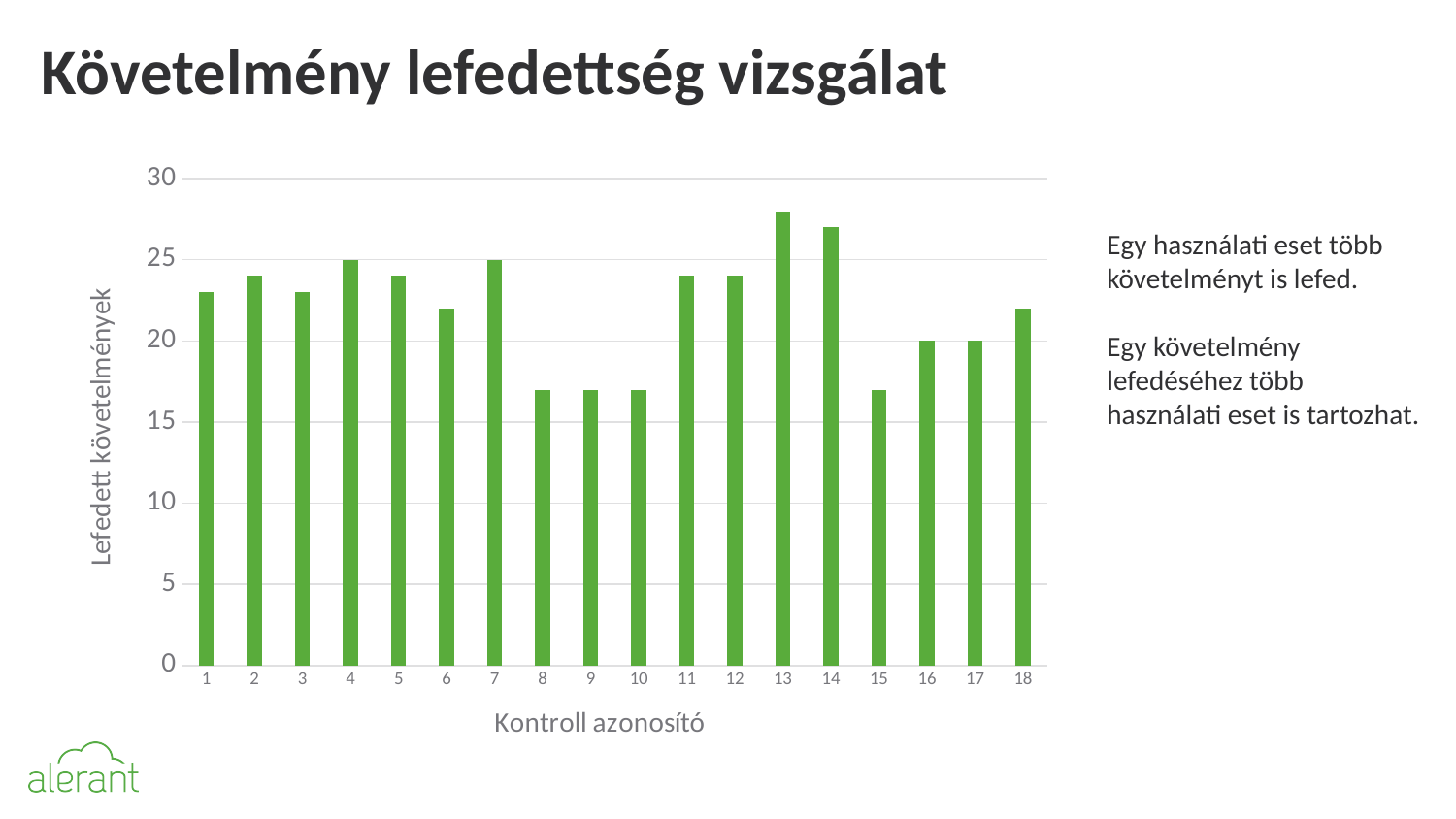
What is the title of the chart's y axis? Lefedett követelmények Is the value for control identifier 8 greater or less than 20? less Is the value for control identifier 15 greater or less than 20? less Which control identifier has the highest number of covered requirements? 13 How many control identifiers (categories) are plotted on the x axis? 18 Which has a larger value, control identifier 13 or control identifier 9? 13 Is the value for control identifier 13 greater or less than 25? greater What is the value for control identifier 4? 25 What kind of chart is shown on the slide? bar chart What is the value for control identifier 16? 20 What is the title of the chart's x axis? Kontroll azonosító